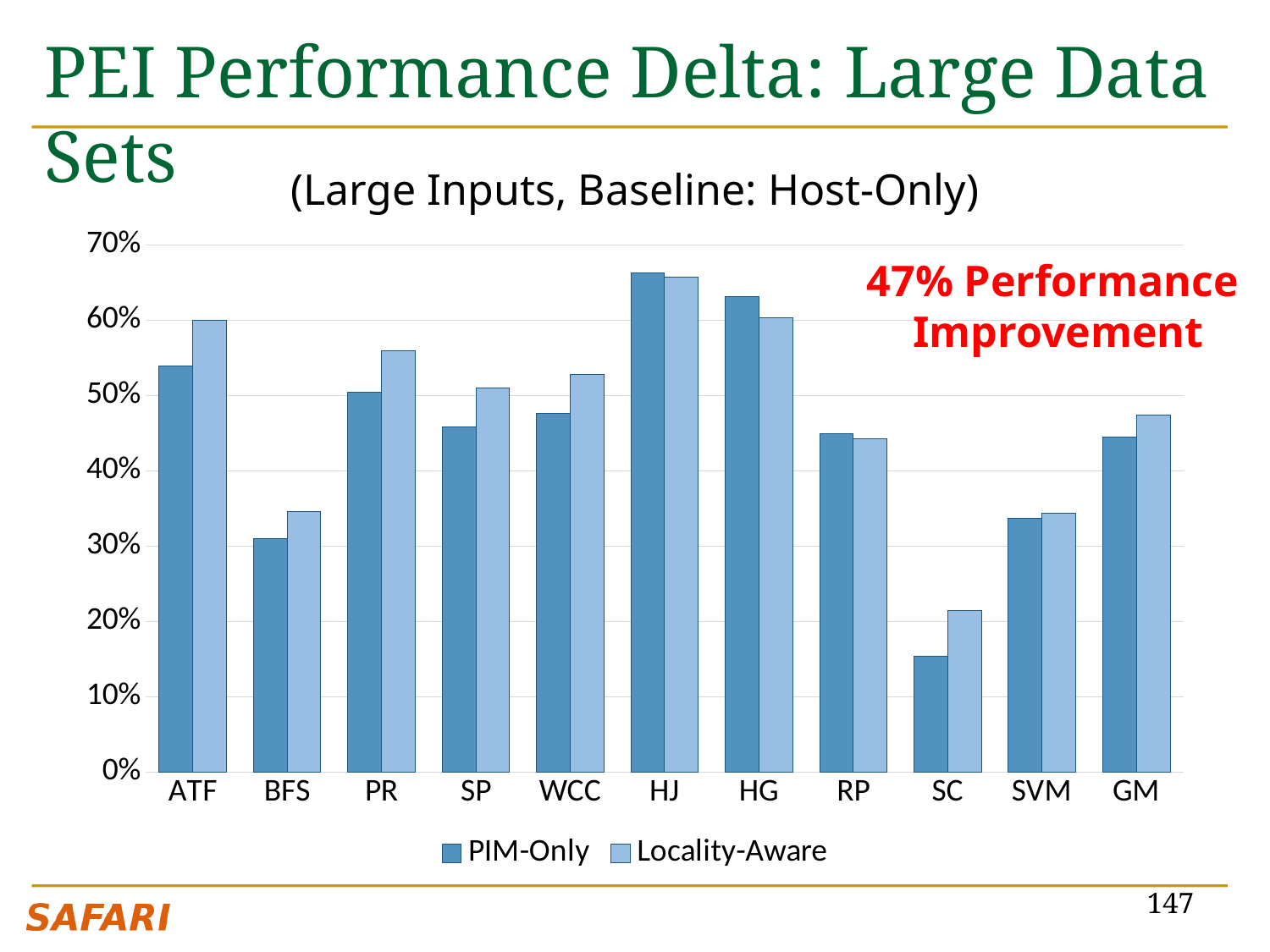
For ATF, which series has the larger value, PIM-Only or Locality-Aware? Locality-Aware How many categories are shown along the x axis of the chart? 11 For HG, which series has the larger value, PIM-Only or Locality-Aware? PIM-Only Is the Locality-Aware value for BFS greater or less than 30%? greater What subtitle is printed above the chart's plot area? (Large Inputs, Baseline: Host-Only) What kind of chart is shown on the slide? Bar chart Which category has the lowest PIM-Only value? SC How many series does the chart's legend list? 2 Is the PIM-Only value for ATF greater or less than 50%? greater Which category has the lowest Locality-Aware value? SC Which category has the highest PIM-Only value? HJ Is the PIM-Only value for SC greater or less than 20%? less